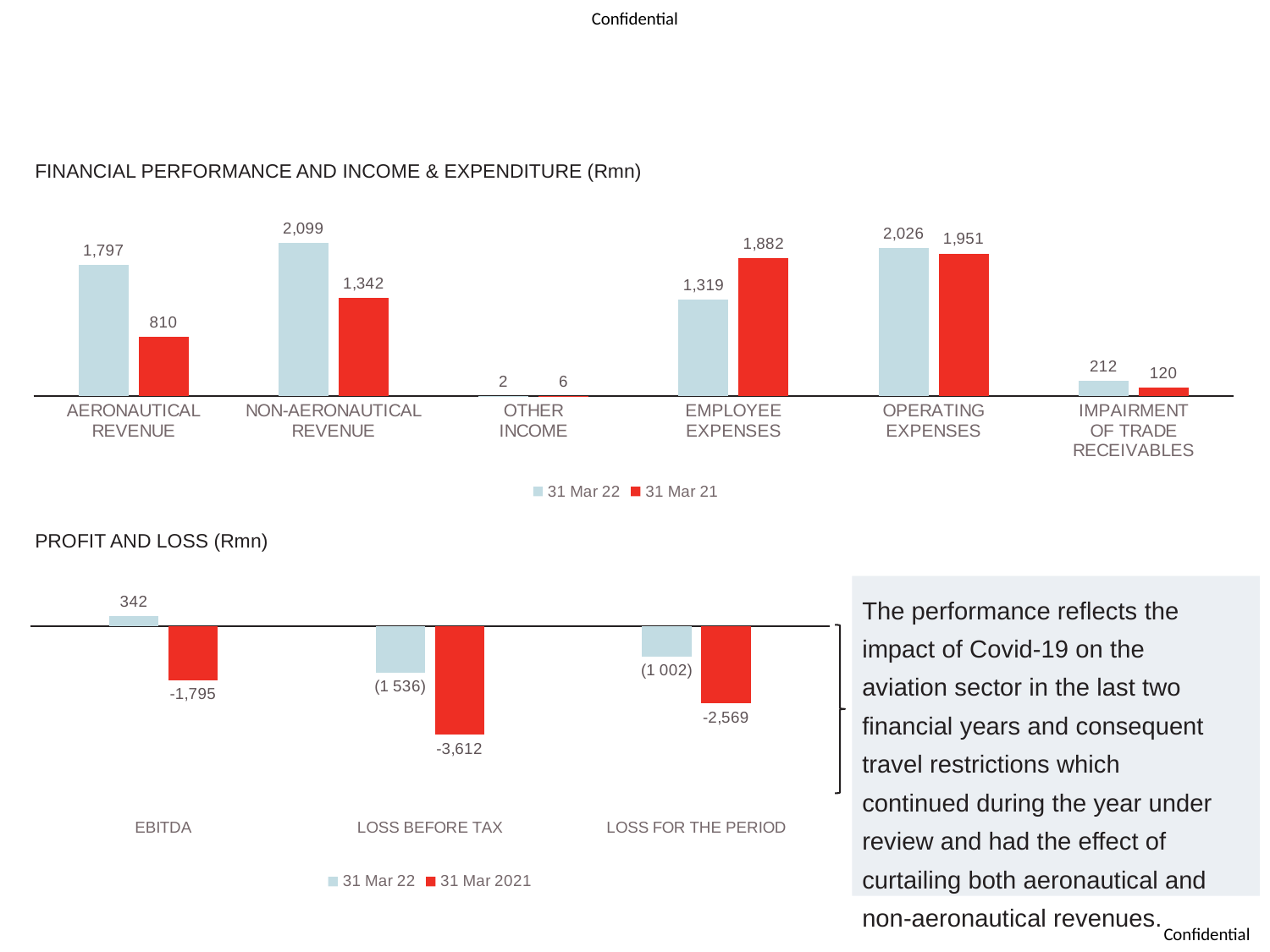
What kind of chart is the PROFIT AND LOSS chart? Bar chart In the PROFIT AND LOSS chart, what is the value for EBITDA for 31 Mar 22? 342 How many categories are shown in the FINANCIAL PERFORMANCE AND INCOME & EXPENDITURE chart? 6 In the PROFIT AND LOSS chart, what is the value for LOSS BEFORE TAX for 31 Mar 2021? -3,612 In the PROFIT AND LOSS chart, what is the value for LOSS FOR THE PERIOD for 31 Mar 22? (1 002) In the FINANCIAL PERFORMANCE AND INCOME & EXPENDITURE chart, which is larger for OPERATING EXPENSES: 31 Mar 22 or 31 Mar 21? 31 Mar 22 In the FINANCIAL PERFORMANCE AND INCOME & EXPENDITURE chart, which category has the lowest value for 31 Mar 21? OTHER INCOME How many series does the legend of the PROFIT AND LOSS chart list? 2 In the FINANCIAL PERFORMANCE AND INCOME & EXPENDITURE chart, what is the value for AERONAUTICAL REVENUE for 31 Mar 22? 1,797 In the FINANCIAL PERFORMANCE AND INCOME & EXPENDITURE chart, what is the difference between the 31 Mar 22 and 31 Mar 21 values for AERONAUTICAL REVENUE? 987 In the FINANCIAL PERFORMANCE AND INCOME & EXPENDITURE chart, what is the value for EMPLOYEE EXPENSES for 31 Mar 21? 1,882 In the FINANCIAL PERFORMANCE AND INCOME & EXPENDITURE chart, which category has the highest value for 31 Mar 22? NON-AERONAUTICAL REVENUE